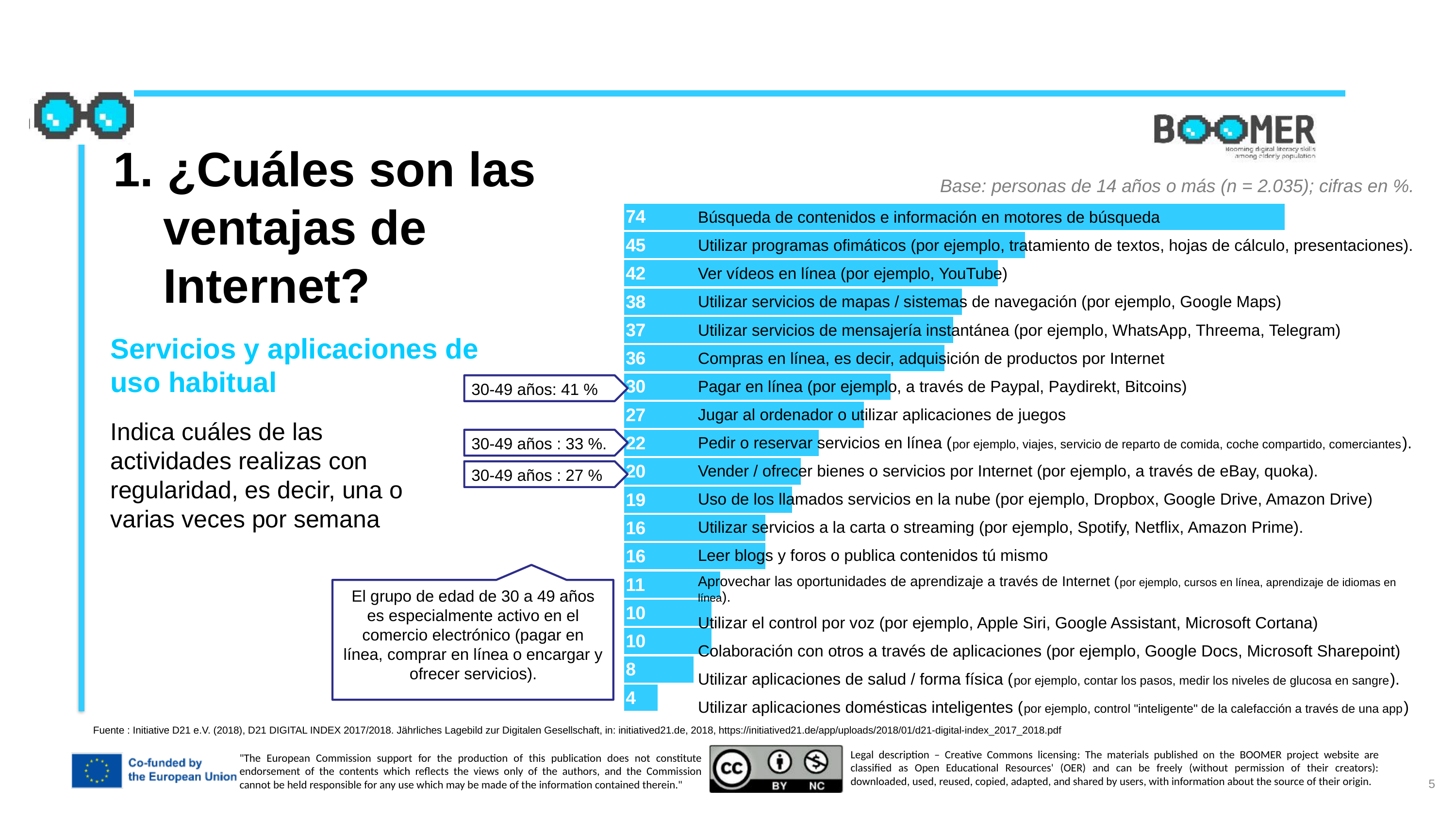
How many activities (bars) are shown in the chart? 18 What value is shown for "Compras en línea, es decir, adquisición de productos por Internet"? 36 What value is shown for "Uso de los llamados servicios en la nube (por ejemplo, Dropbox, Google Drive, Amazon Drive)"? 19 What value is shown for "Ver vídeos en línea (por ejemplo, YouTube)"? 42 What is the difference between the value for "Búsqueda de contenidos e información en motores de búsqueda" and the value for "Utilizar programas ofimáticos"? 29 Which activity has the highest value in the chart? Búsqueda de contenidos e información en motores de búsqueda Which activity has the lowest value in the chart? Utilizar aplicaciones domésticas inteligentes Which has a larger value: "Utilizar servicios de mapas / sistemas de navegación" or "Utilizar servicios de mensajería instantánea"? Utilizar servicios de mapas / sistemas de navegación What is the difference between the value for "Pagar en línea" and the value for "Jugar al ordenador o utilizar aplicaciones de juegos"? 3 What kind of chart is shown on the slide? Bar chart According to the callout next to "Pagar en línea", what is the value for the 30-49 años age group? 41 % Which has a larger value: "Utilizar aplicaciones de salud / forma física" or "Utilizar el control por voz"? Utilizar el control por voz